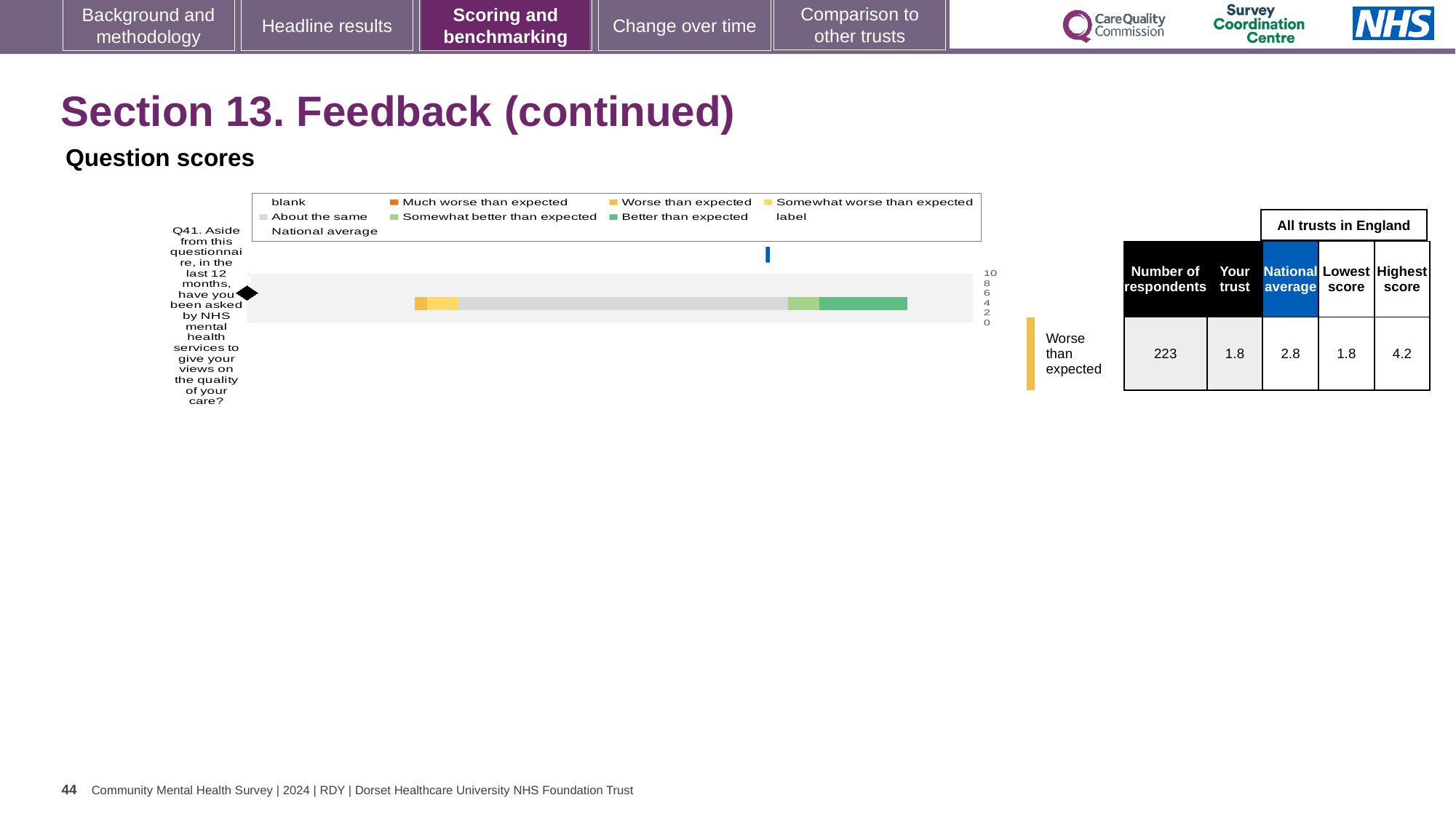
What colour is the national average marker on the chart? Blue Which benchmark category is the trust's Q41 score assigned to? Worse than expected How many survey questions are plotted on the chart? 1 What is the difference between the highest and lowest scores for Q41 across all trusts in England? 2.4 What is the highest score among all trusts in England for Q41? 4.2 How many respondents answered Q41? 223 What kind of chart is used to show the Q41 question score? bar chart Which is larger for Q41: the trust's score or the national average? National average What is the 'Your trust' score for Q41? 1.8 What is the lowest score among all trusts in England for Q41? 1.8 By how much does the national average exceed the trust's score for Q41? 1.0 What is the national average score for Q41? 2.8